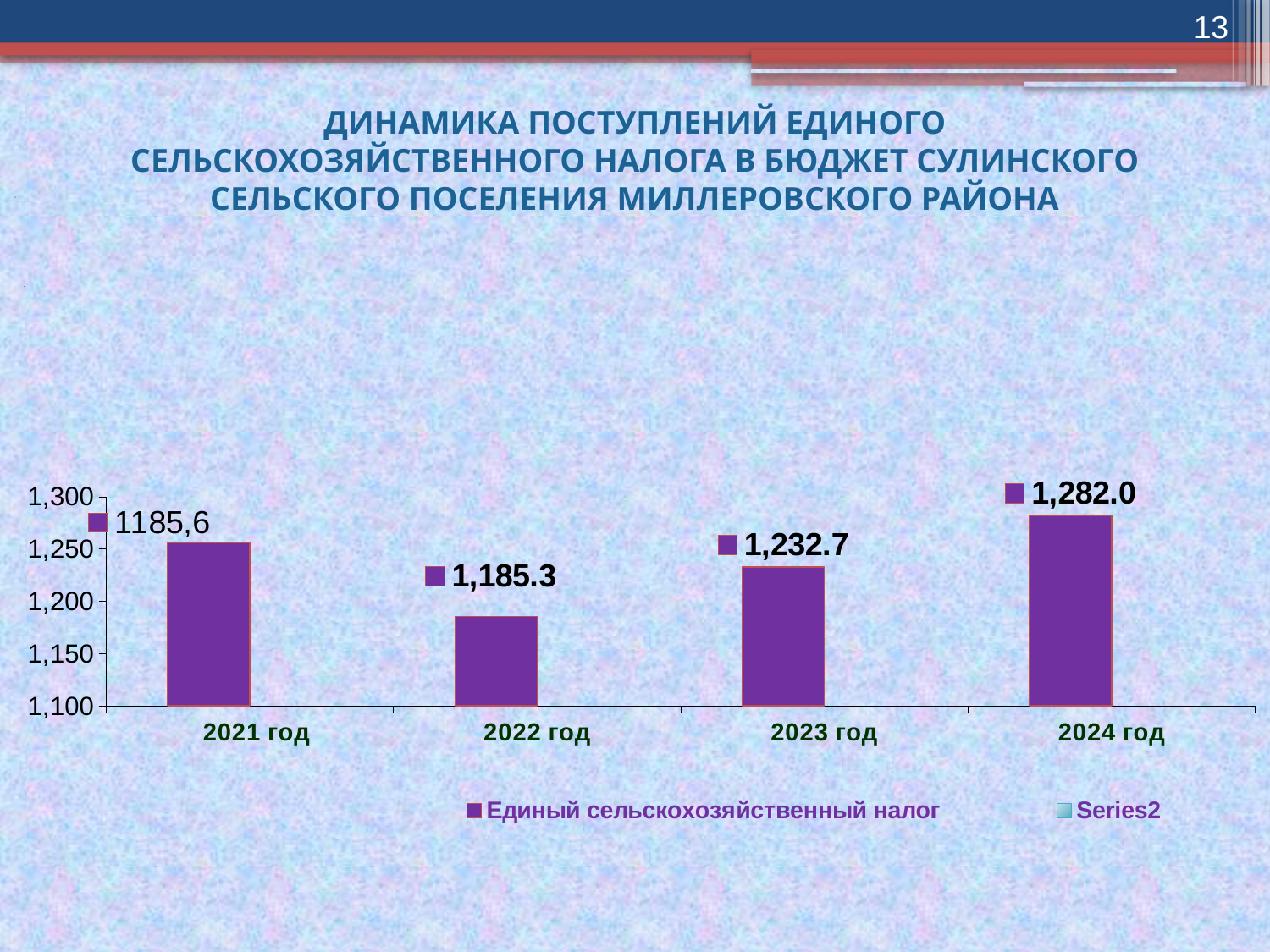
How many years are shown on the x axis? 4 What kind of chart is shown on the slide? bar chart What is the difference between the values for 2023 год and 2022 год? 47.4 What is the difference between the values for 2024 год and 2023 год? 49.3 What is the value for 2023 год? 1,232.7 Which year has the highest value? 2024 год How many series does the legend list? 2 What is the value for 2022 год? 1,185.3 Is the value for 2022 год greater or less than 1,200? less Which year has the lowest value? 2022 год What is the value for 2024 год? 1,282.0 Which is larger, the value for 2023 год or 2022 год? 2023 год